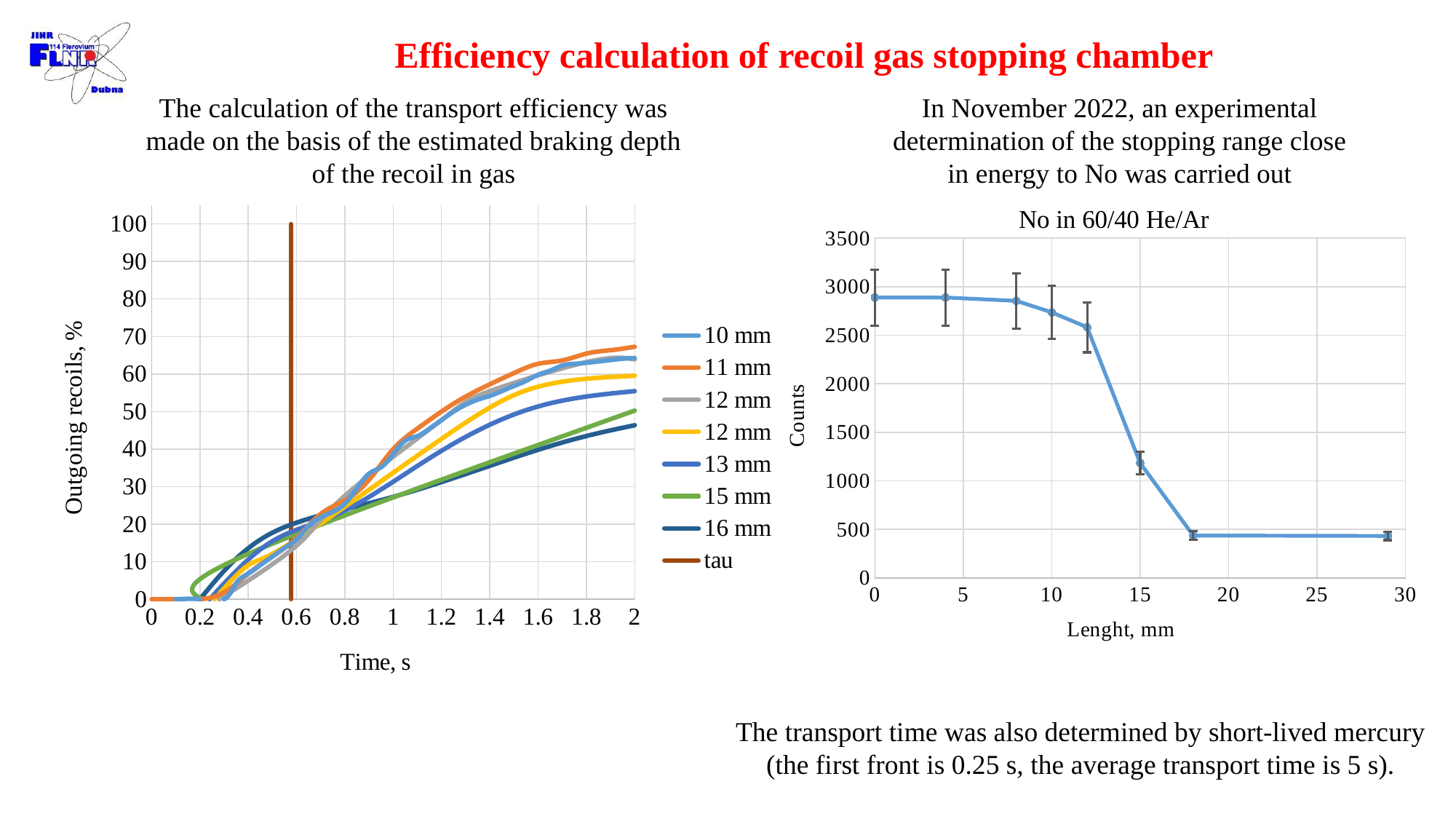
On the left chart, which series is lowest at 2 s? 16 mm On the left chart, do the values for 10 mm rise or fall as time increases? rise What kind of chart is the left chart (Outgoing recoils vs Time)? line chart On the left chart, is the value for 11 mm at 2 s greater or less than 60? greater How many series does the legend of the left chart list? 8 On the right chart (No in 60/40 He/Ar), is the value at 18 mm greater or less than 500? less On the right chart (No in 60/40 He/Ar), which is larger, the value at 12 mm or at 15 mm? 12 mm How many data points are plotted on the right chart (No in 60/40 He/Ar)? 8 On the right chart (No in 60/40 He/Ar), is the value at 0 mm greater or less than 2500? greater On the left chart, which series is highest at 2 s? 11 mm What is the title of the right chart? No in 60/40 He/Ar